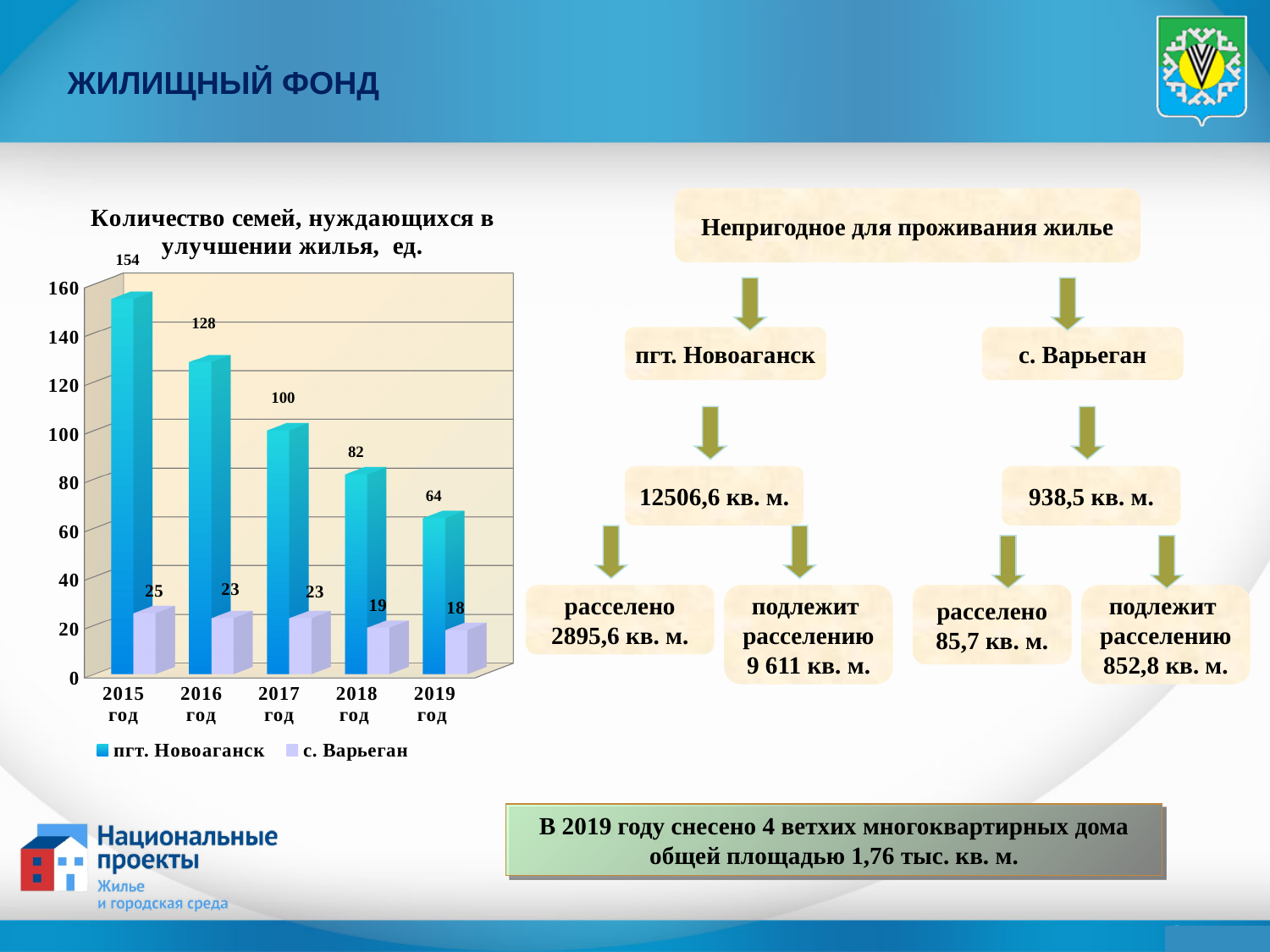
What is the value for пгт. Новоаганск in 2017 год? 100 How many years are shown on the x axis of the chart? 5 How many series does the chart legend list? 2 What is the difference between the пгт. Новоаганск values for 2015 год and 2019 год? 90 What kind of chart is shown on the slide? bar chart Which year has the highest value for пгт. Новоаганск? 2015 год Which year has the lowest value for с. Варьеган? 2019 год Do the values for пгт. Новоаганск rise or fall from 2015 год to 2019 год? fall What is the value for пгт. Новоаганск in 2015 год? 154 What is the value for с. Варьеган in 2019 год? 18 What is the title of the chart? Количество семей, нуждающихся в улучшении жилья, ед. Which is larger, the пгт. Новоаганск value for 2018 год or the пгт. Новоаганск value for 2019 год? 2018 год